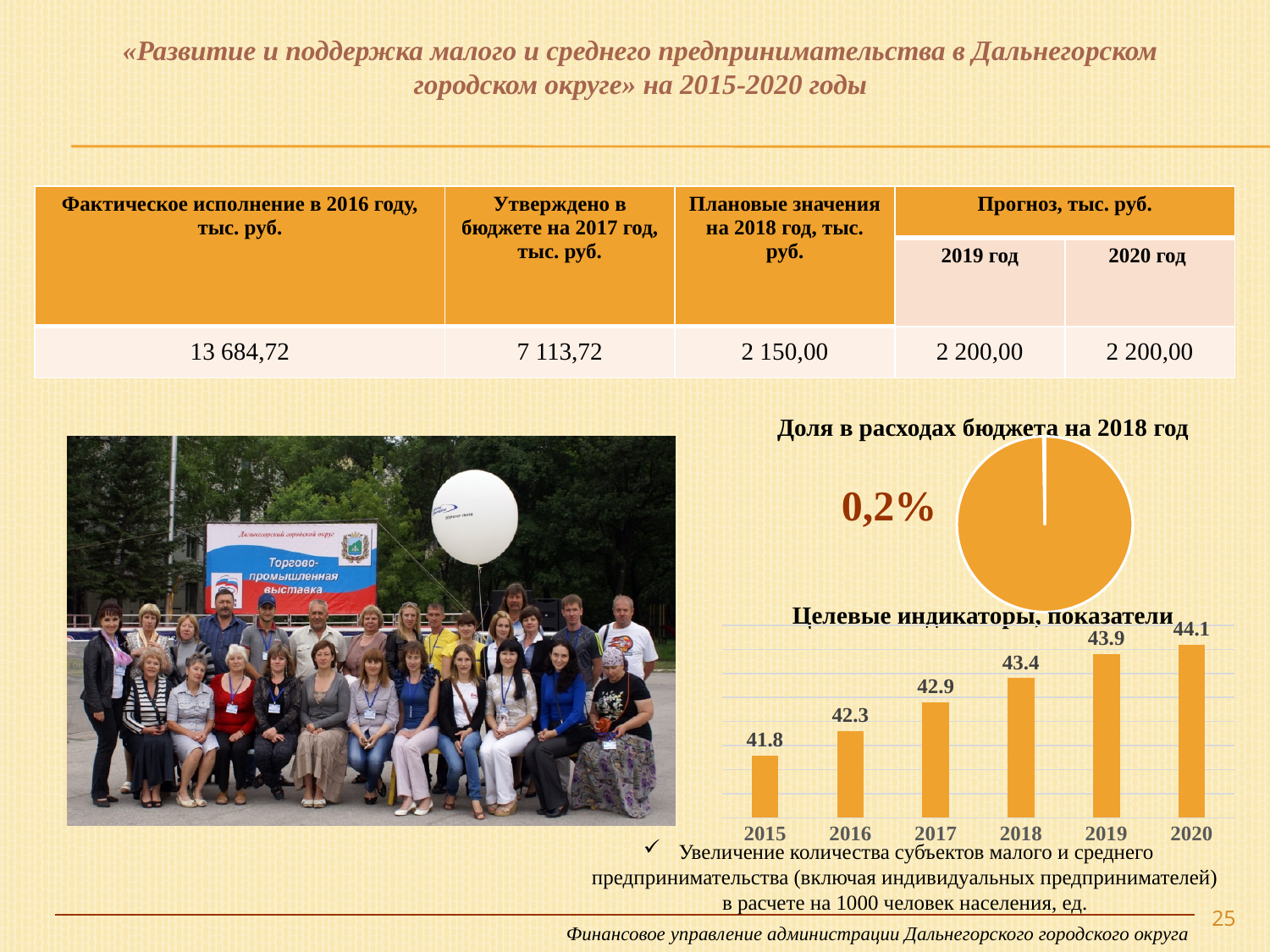
What kind of chart is the one titled "Доля в расходах бюджета на 2018 год"? pie chart In the chart titled "Целевые индикаторы, показатели", what is the value for 2015? 41.8 What kind of chart is the one titled "Целевые индикаторы, показатели"? bar chart In the chart titled "Целевые индикаторы, показатели", which is larger, the value for 2017 or the value for 2016? 2017 In the chart titled "Целевые индикаторы, показатели", what is the value for 2020? 44.1 In the chart titled "Целевые индикаторы, показатели", what is the difference between the values for 2020 and 2015? 2.3 In the chart titled "Целевые индикаторы, показатели", which year has the highest value? 2020 In the chart titled "Доля в расходах бюджета на 2018 год", what share is labelled on the slide? 0,2% In the chart titled "Целевые индикаторы, показатели", what is the value for 2018? 43.4 In the chart titled "Целевые индикаторы, показатели", which year has the lowest value? 2015 In the chart titled "Целевые индикаторы, показатели", how many years are shown on the x axis? 6 In the chart titled "Целевые индикаторы, показатели", do the values rise or fall from 2015 to 2020? rise